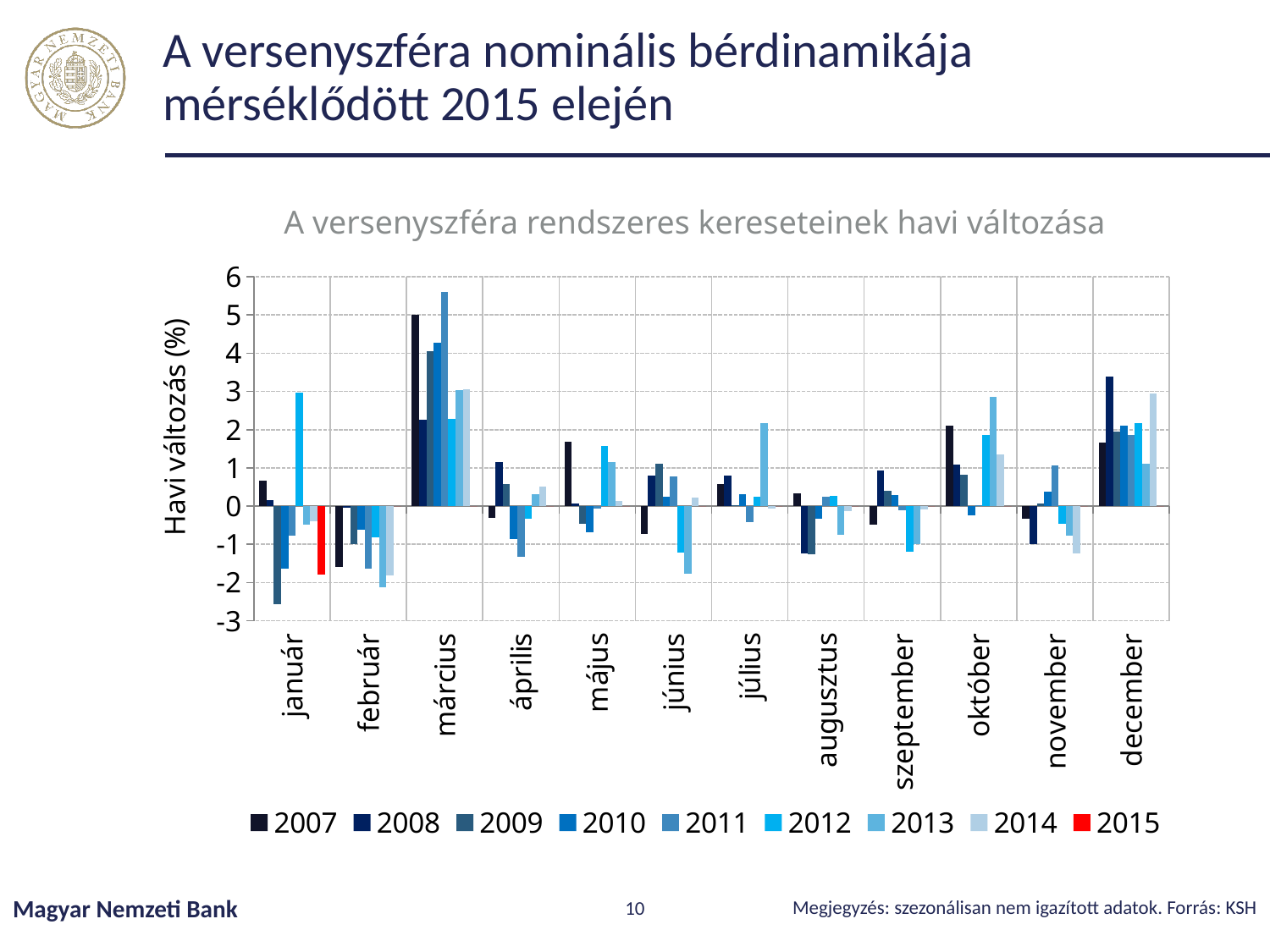
Is the value for 2009 in január greater or less than -2? less In which month does the highest bar of the whole chart appear? március Is the value for 2008 in december greater or less than 3? greater Is the value for 2013 in október greater or less than 2? greater How many series does the legend list? 9 Which year has the lowest value in január? 2009 How many month categories are shown on the x axis? 12 What is the title of the chart? A versenyszféra rendszeres kereseteinek havi változása What kind of chart is shown on the slide? bar chart Which series is drawn in red in the legend? 2015